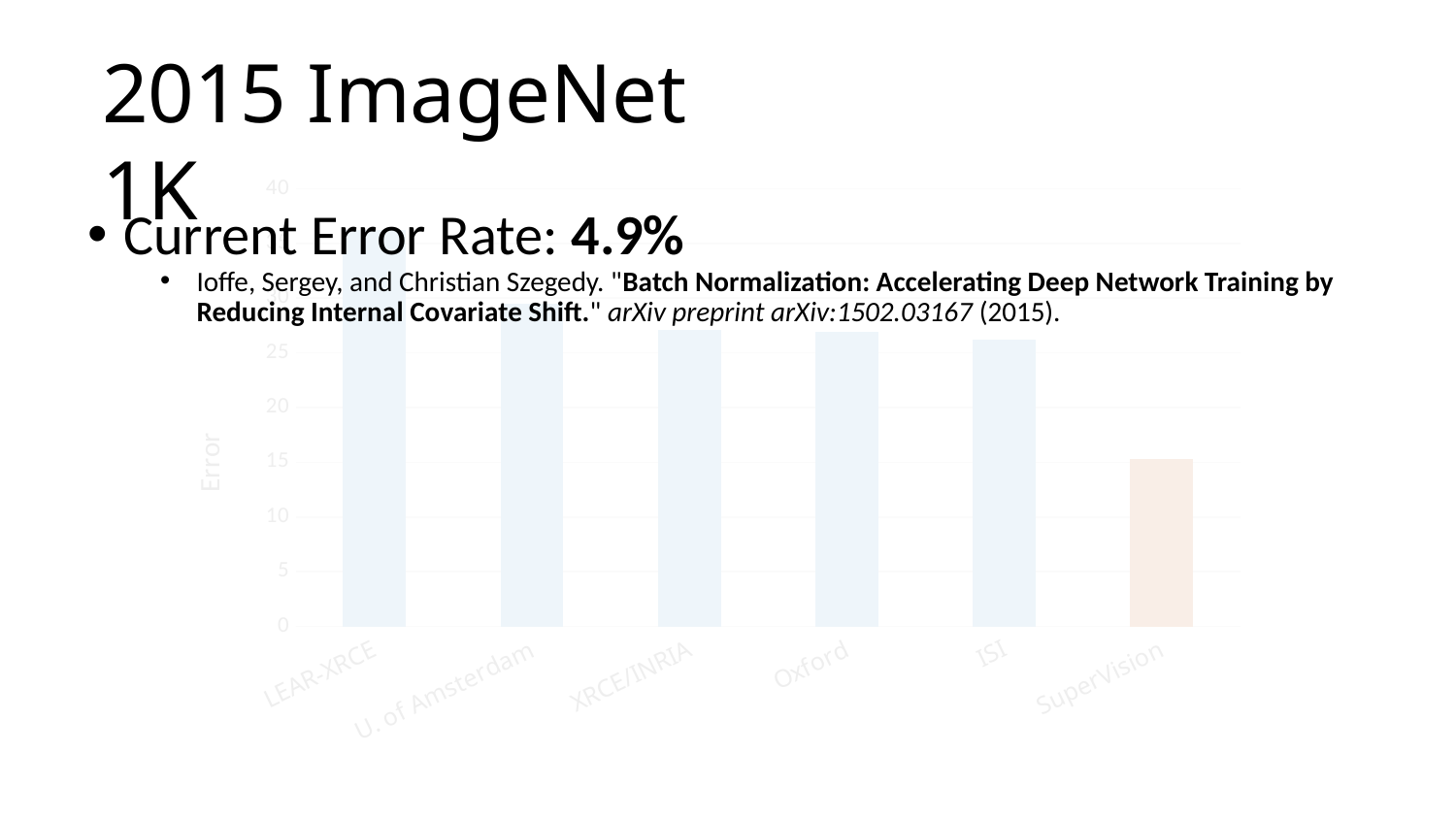
Do the bar values generally rise or fall from left to right along the x axis? fall Is the value for SuperVision greater or less than 20? less Which has a higher error, LEAR-XRCE or SuperVision? LEAR-XRCE Is the value for LEAR-XRCE greater or less than 30? greater What kind of chart is shown on the slide? bar chart Which has a higher error, U. of Amsterdam or SuperVision? U. of Amsterdam How many categories are shown on the x axis of the chart? 6 Is the value for Oxford greater or less than 20? greater Which category has the highest error in the chart? LEAR-XRCE What is the label on the y axis of the chart? Error Which category has the lowest error in the chart? SuperVision